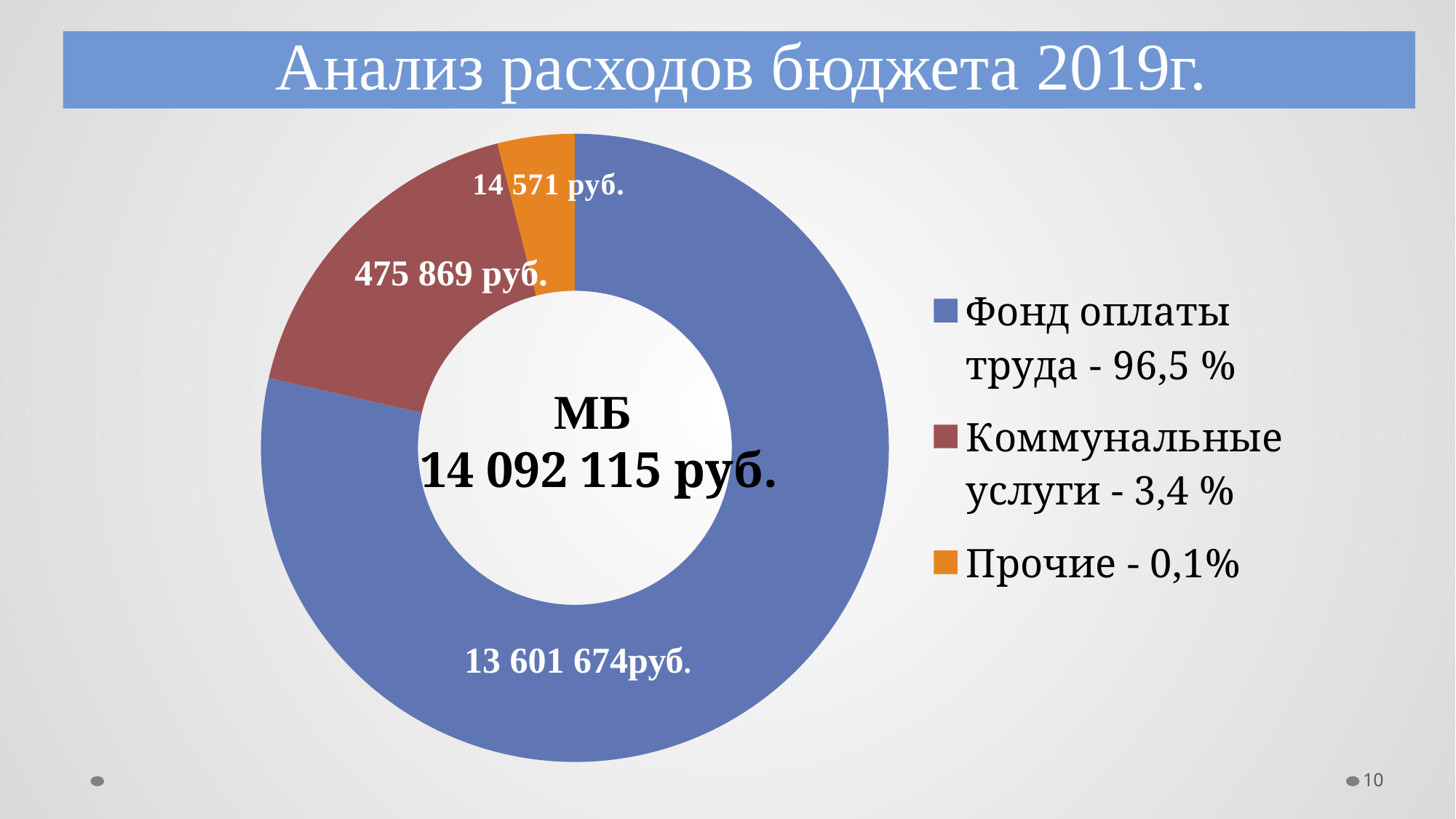
What total amount is printed in the centre of the chart? МБ 14 092 115 руб. How many categories does the chart show? 3 What is the difference between the values for Коммунальные услуги and Прочие? 461 298 руб. Which is larger, the value for Коммунальные услуги or the value for Прочие? Коммунальные услуги Which category has the largest slice? Фонд оплаты труда What kind of chart is shown on the slide? Doughnut (pie) chart What is the difference between the values for Фонд оплаты труда and Коммунальные услуги? 13 125 805 руб. Which category has the smallest slice? Прочие What is the value shown for Коммунальные услуги? 475 869 руб. What is the value shown for Прочие? 14 571 руб. What share of the total does Коммунальные услуги represent according to the legend? 3,4 % What is the value shown for Фонд оплаты труда? 13 601 674руб.